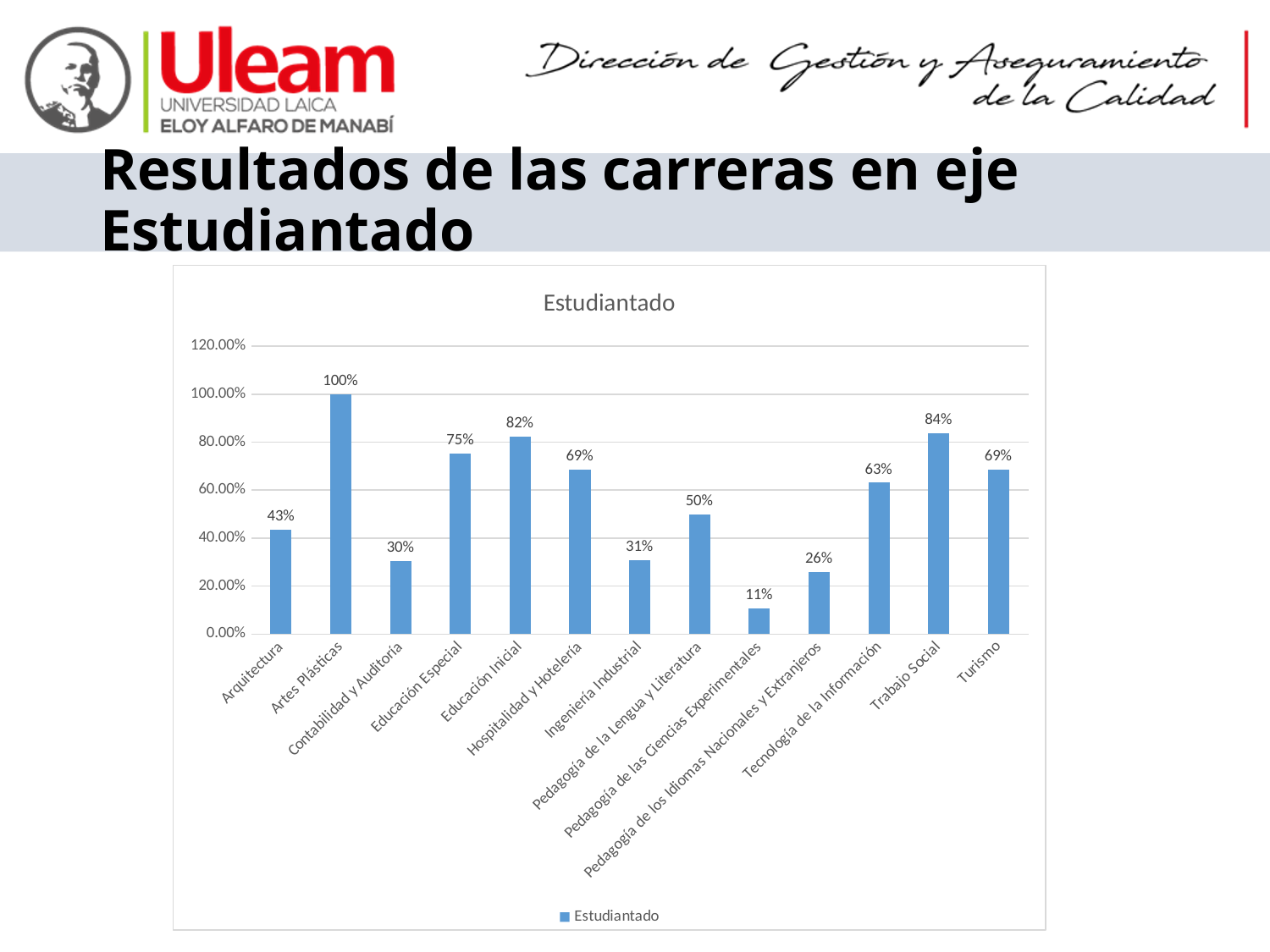
What is the value for Pedagogía de la Lengua y Literatura? 50% Which category has the lowest value? Pedagogía de las Ciencias Experimentales What is the difference between the values for Trabajo Social and Educación Especial? 9% What is the title of the chart? Estudiantado Which is larger, the value for Educación Inicial or the value for Hospitalidad y Hotelería? Educación Inicial Which category has the highest value? Artes Plásticas What kind of chart is shown? bar chart How many categories are shown on the x axis? 13 Is the value for Contabilidad y Auditoría greater or less than 40.00%? less What is the value for Tecnología de la Información? 63% How many series does the legend list? 1 What is the value for Arquitectura? 43%